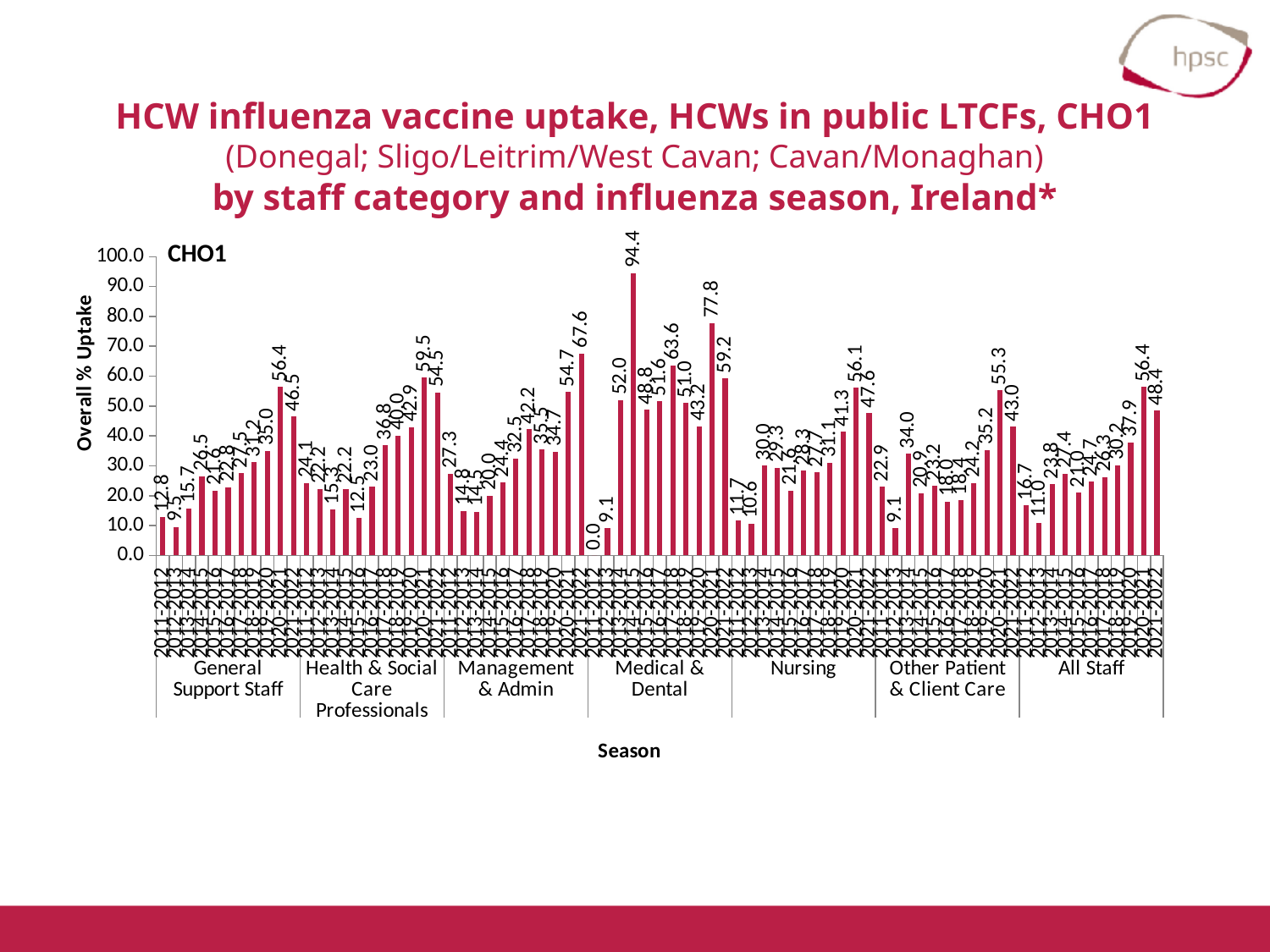
Which is larger in 2021-2022: the uptake for Management & Admin or for Nursing? Management & Admin What is the overall % uptake for All Staff in 2020-2021? 56.4 What is the overall % uptake for Medical & Dental in 2011-2012? 0.0 What is the overall % uptake for Health & Social Care Professionals in 2020-2021? 59.5 What is the highest value printed on the chart? 94.4 What kind of chart is shown on the slide? Bar chart What is the label on the vertical axis of the chart? Overall % Uptake Is the value for Medical & Dental in 2019-2020 greater or less than 70? less How many staff categories are shown along the x axis? 7 Which staff category and season has the highest overall % uptake on the chart? Medical & Dental, 2014-2015 (94.4) What is the overall % uptake for All Staff in 2021-2022? 48.4 What is the difference between the All Staff uptake in 2020-2021 and in 2021-2022? 8.0